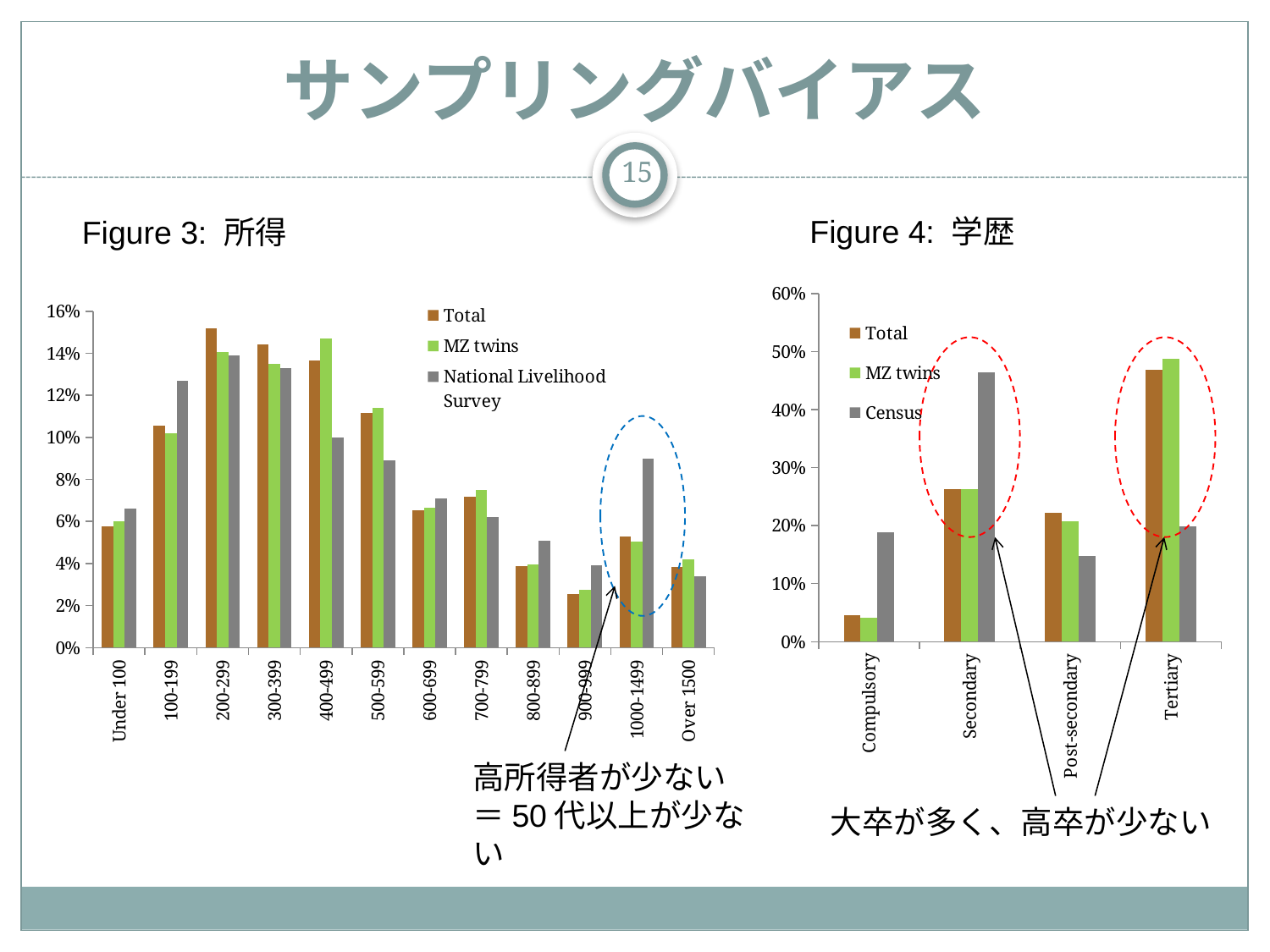
In Figure 3: 所得, which income category has the highest Total value? 200-299 How many series does the legend of Figure 4: 学歴 list? 3 What kind of chart is Figure 3: 所得? bar chart In Figure 3: 所得, is the National Livelihood Survey value for 1000-1499 greater or less than 8%? greater In Figure 4: 学歴, for Secondary, which is larger: the Census value or the Total value? Census In Figure 4: 学歴, which education category has the highest Census value? Secondary How many income categories are shown on the x axis of Figure 3: 所得? 12 In Figure 3: 所得, is the Total value for 200-299 greater or less than 14%? greater In Figure 4: 学歴, is the Total value for Compulsory greater or less than 10%? less In Figure 3: 所得, what is the name of the third series in the legend? National Livelihood Survey How many education categories are shown on the x axis of Figure 4: 学歴? 4